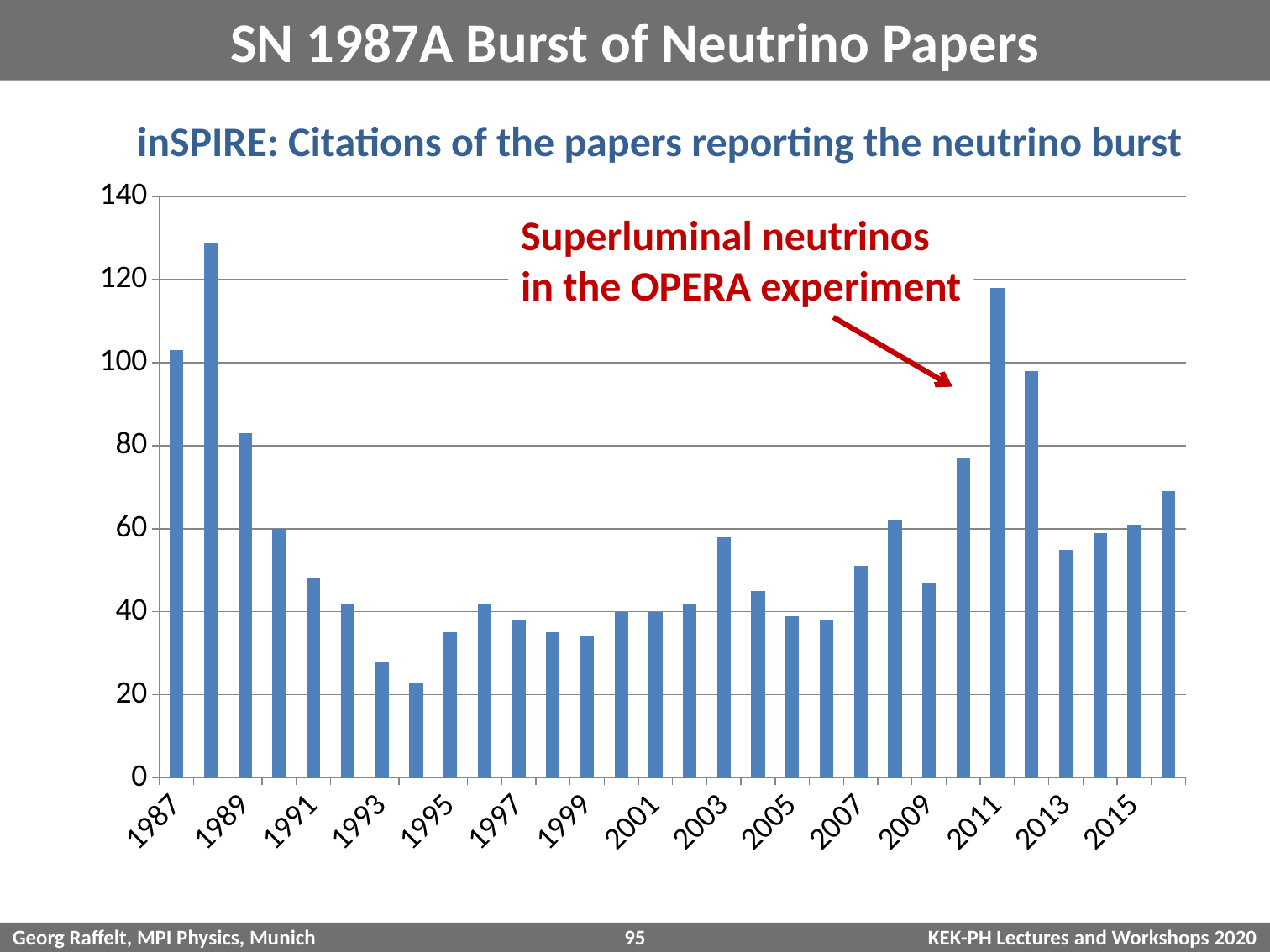
Which year has the larger value, 1993 or 2003? 2003 Is the value for 1991 greater or less than 40? greater Is the value for 2007 greater or less than 40? greater Which year has the larger value, 1989 or 2013? 1989 Do the values rise or fall from 1987 to 1993? fall Is the value for 2011 greater or less than 100? greater What event does the red annotation on the chart point to? Superluminal neutrinos in the OPERA experiment What kind of chart is shown on the slide? bar chart Which year has the larger value, 2011 or 1987? 2011 What is the title of the chart? inSPIRE: Citations of the papers reporting the neutrino burst